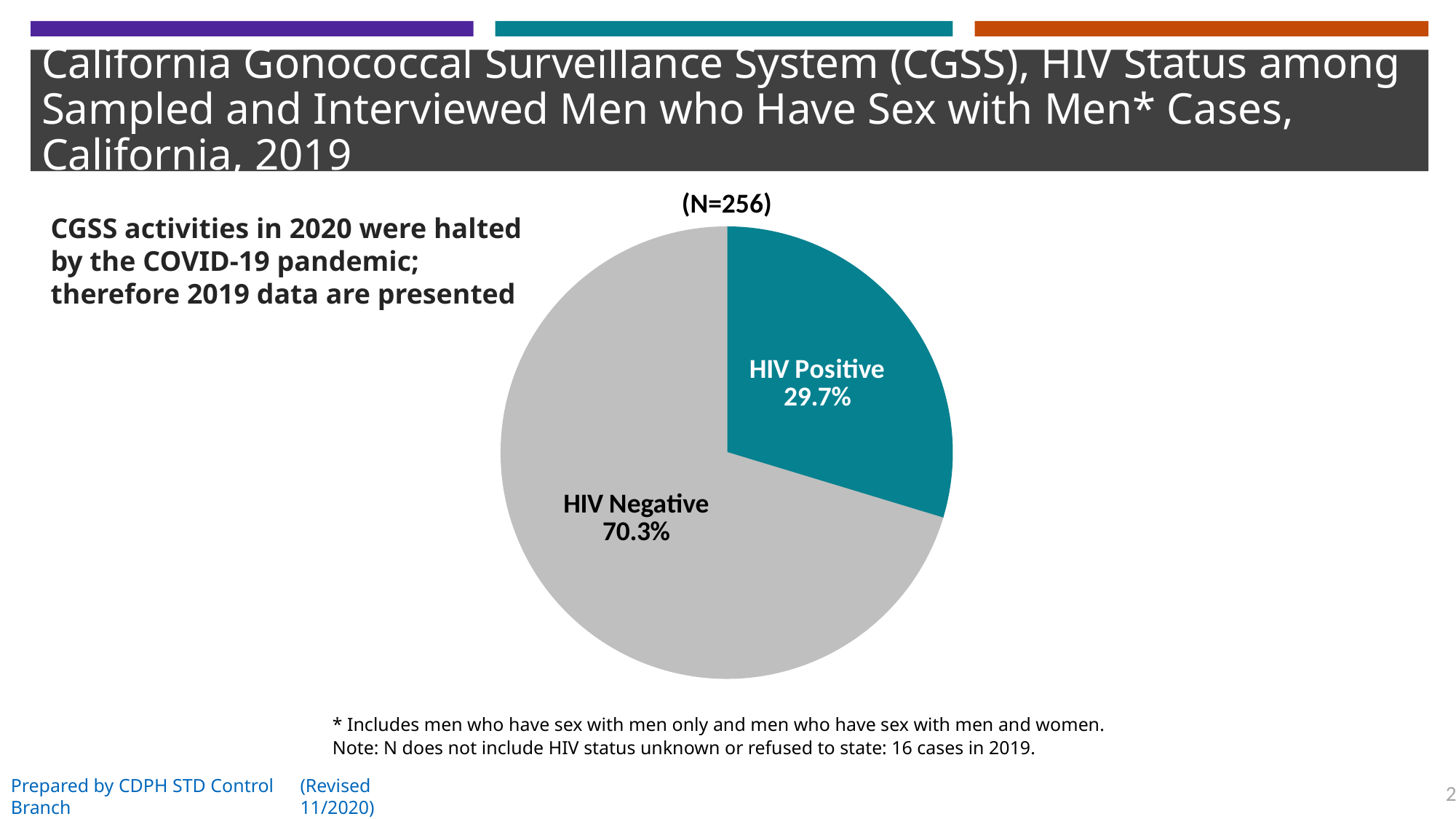
What percentage of cases are HIV Negative? 70.3% What is the N value shown above the pie chart? N=256 Which slice of the pie is the smallest? HIV Positive Which is larger, the HIV Positive slice or the HIV Negative slice? HIV Negative What colour is the HIV Positive slice? teal What share of the pie does the HIV Positive slice represent? 29.7% What percentage of cases are HIV Positive? 29.7% What is the difference in percentage points between the HIV Negative and HIV Positive slices? 40.6 How many slices does the pie chart have? 2 Which slice of the pie is the largest? HIV Negative What kind of chart is shown on the slide? pie chart